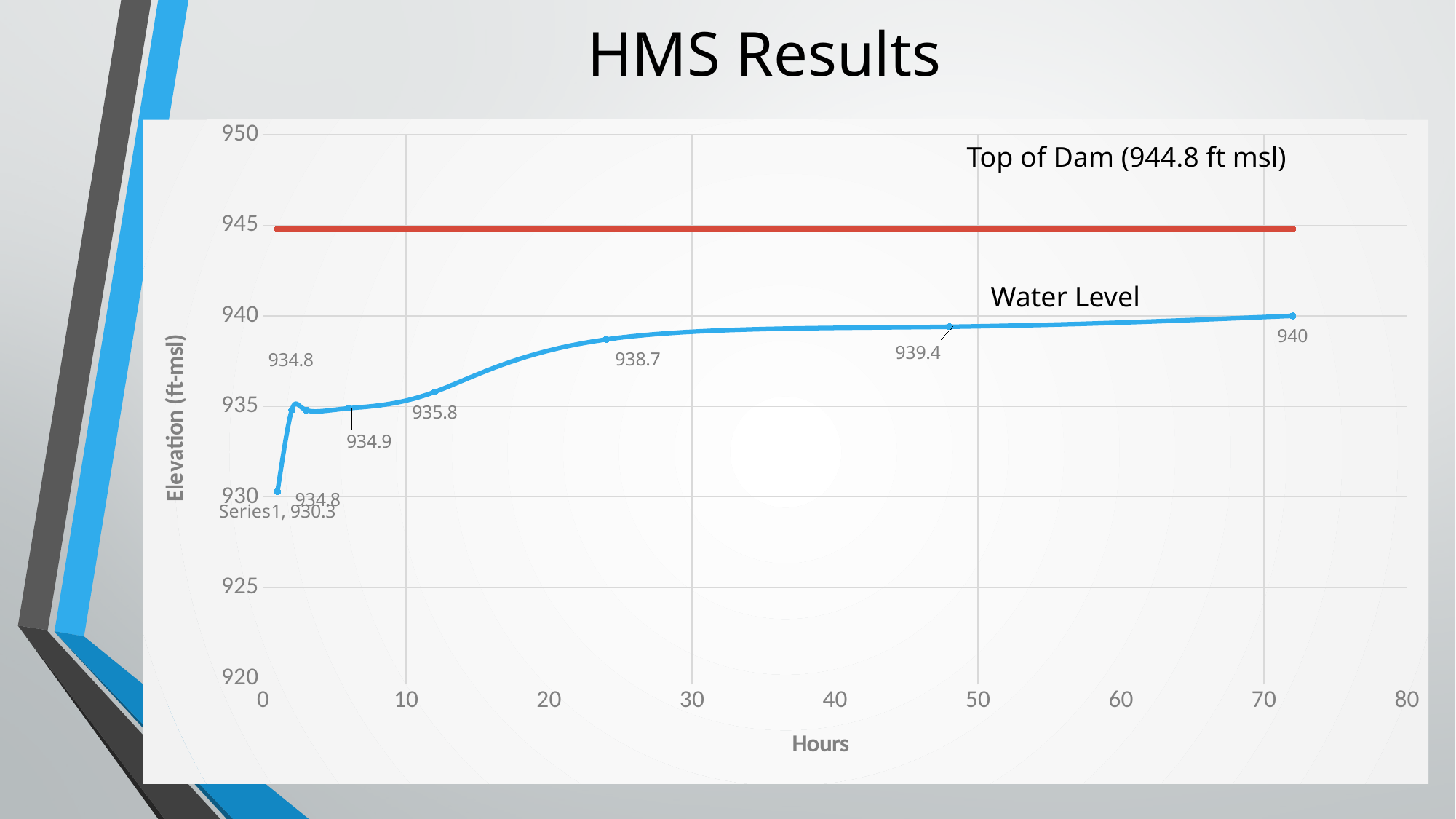
Which is larger, the Water Level at about 24 hours or at about 12 hours? 24 hours What is the Water Level value labeled at about 48 hours? 939.4 What is the highest labeled Water Level value? 940 What is the Water Level value labeled at about 24 hours? 938.7 What is the title of the vertical axis? Elevation (ft-msl) What is the lowest labeled Water Level value? 930.3 What is the difference between the highest Water Level (940) and the lowest Water Level (930.3)? 9.7 What is the final Water Level value at the right end of the series (around 72 hours)? 940 What type of chart is shown on the slide? line chart How far below the Top of Dam (944.8) is the final Water Level (940)? 4.8 What is the elevation of the Top of Dam line? 944.8 ft msl Does the Water Level generally rise or fall as hours increase? rise